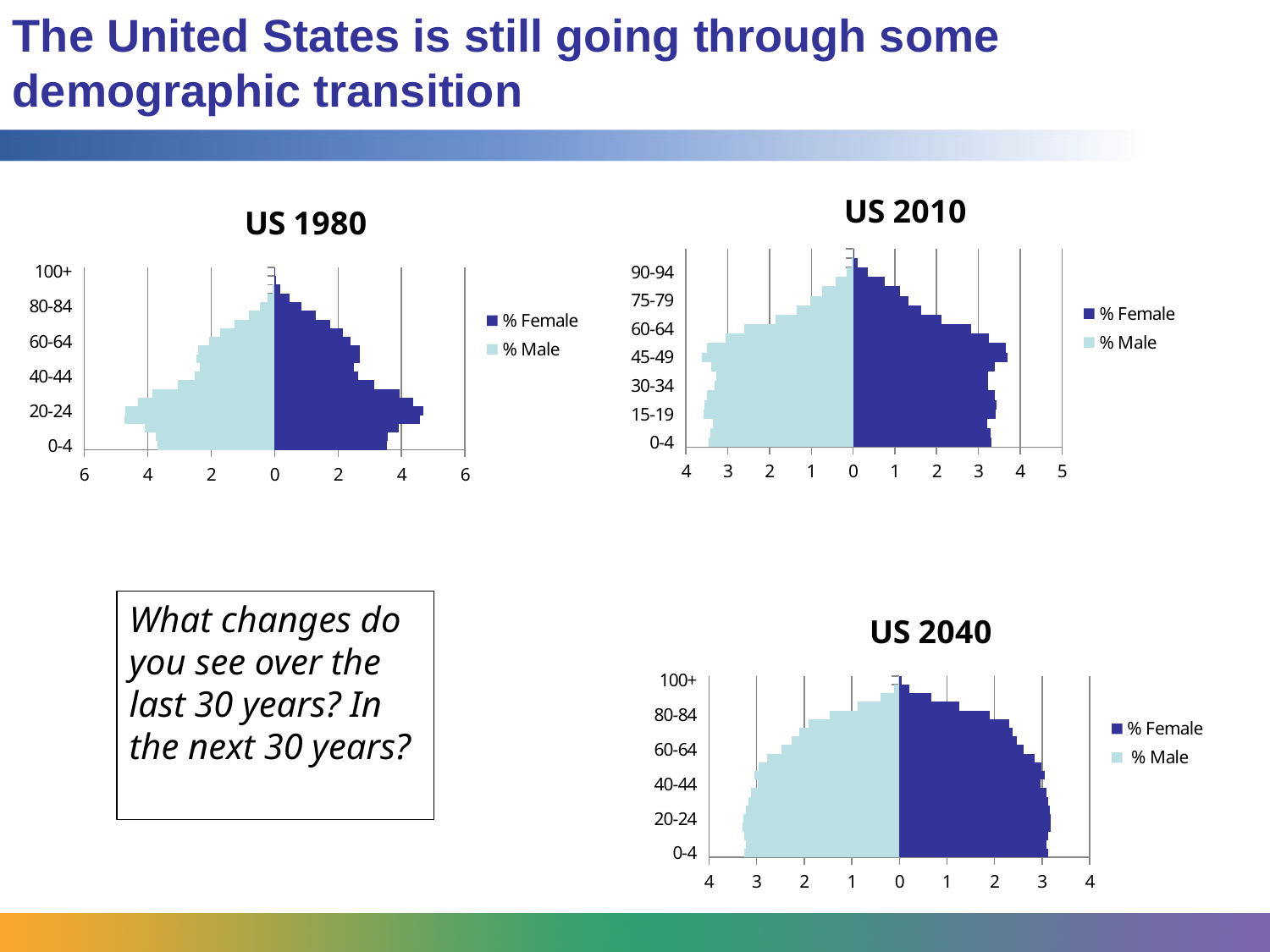
What are the two legend entries on the US 2040 chart? % Female and % Male In the US 1980 chart, is the % Female value for 20-24 greater or less than 4? greater In the US 2040 chart, is the % Male value for 80-84 greater or less than 2? less In the US 2010 chart, is the % Male value for 75-79 greater or less than 2? less What kind of chart is the US 1980 chart? bar chart In the US 1980 chart, which age group has the largest % Female bar? 20-24 What is the title of the chart at the bottom right of the slide? US 2040 In the US 1980 chart, do the % Female bars get larger or smaller moving from the 20-24 age group up to 100+? smaller How many series does the legend of the US 2010 chart list? 2